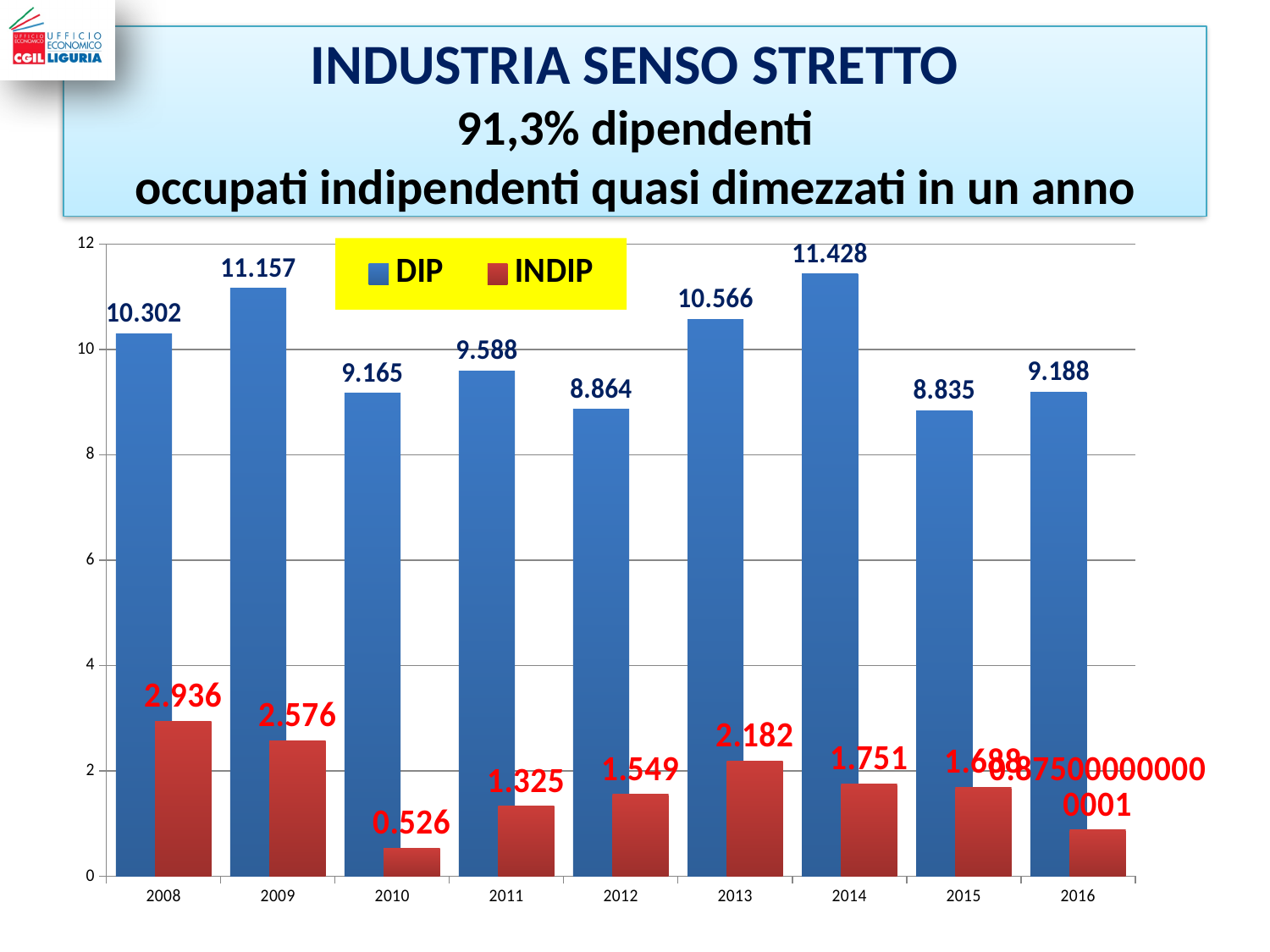
Is the DIP value for 2009 larger or smaller than the DIP value for 2013? larger Is the INDIP value for 2011 greater or less than 2? less What kind of chart is shown on the slide? bar chart How many years are shown on the x axis? 9 What is the DIP value for 2012? 8.864 Which year has the highest INDIP value? 2008 What is the INDIP value for 2013? 2.182 How many series does the legend list? 2 What is the DIP value for 2014? 11.428 Which year has the highest DIP value? 2014 Which year has the lowest DIP value? 2015 What is the INDIP value for 2010? 0.526